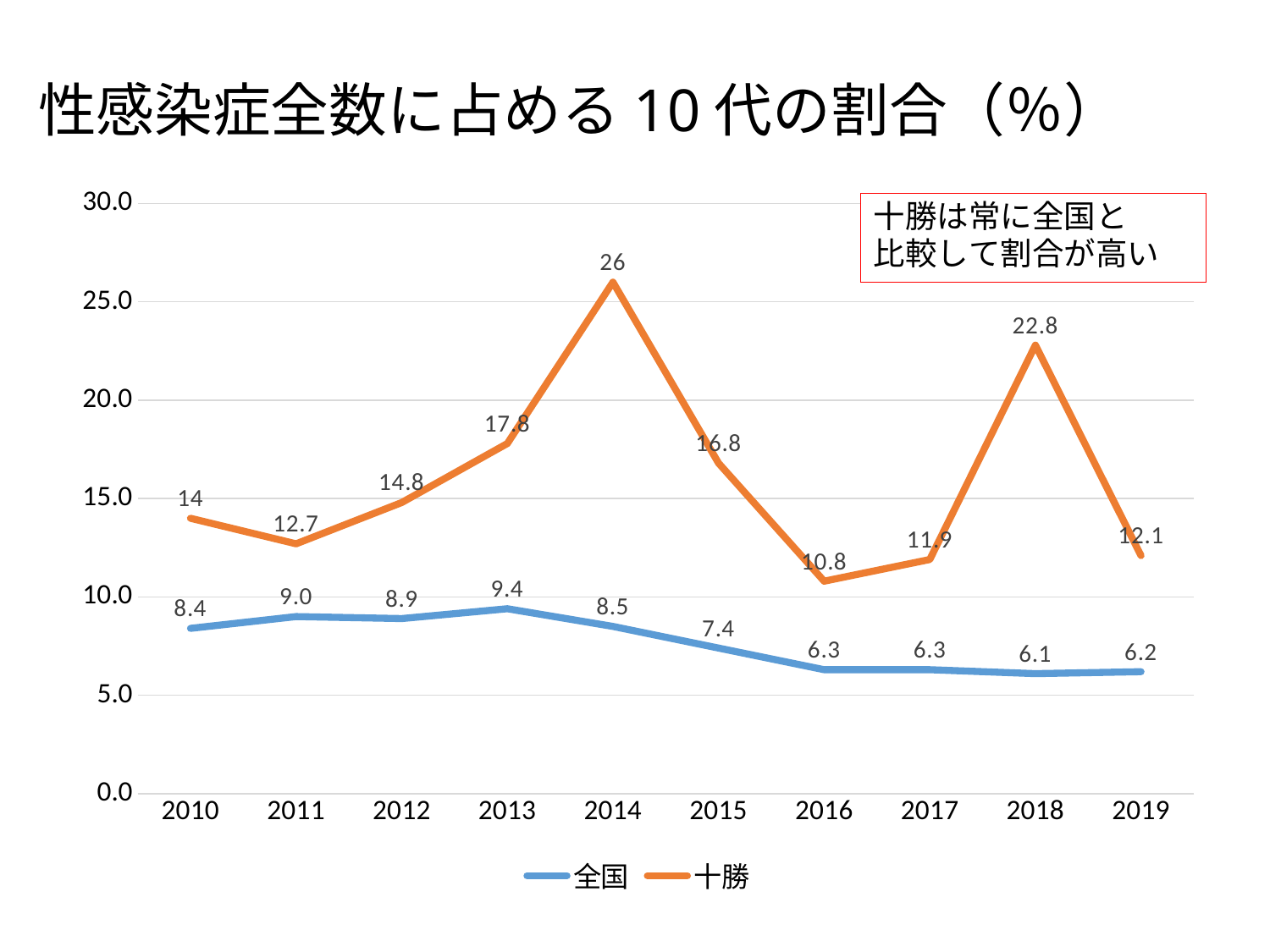
What is the difference between 十勝 and 全国 in 2018? 16.7 What is the value for 十勝 in 2019? 12.1 In which year is the 十勝 series highest? 2014 Does the 全国 series rise or fall from 2013 to 2016? fall Is the value for 十勝 in 2013 greater or less than 15.0? greater How many series does the legend list? 2 What kind of chart is shown on the slide? line chart Which is larger in 2016, the value for 十勝 or the value for 全国? 十勝 In which year is the 全国 series lowest? 2018 What is the value for 全国 in 2013? 9.4 What is the value for 十勝 in 2014? 26 How many years are shown on the x axis? 10